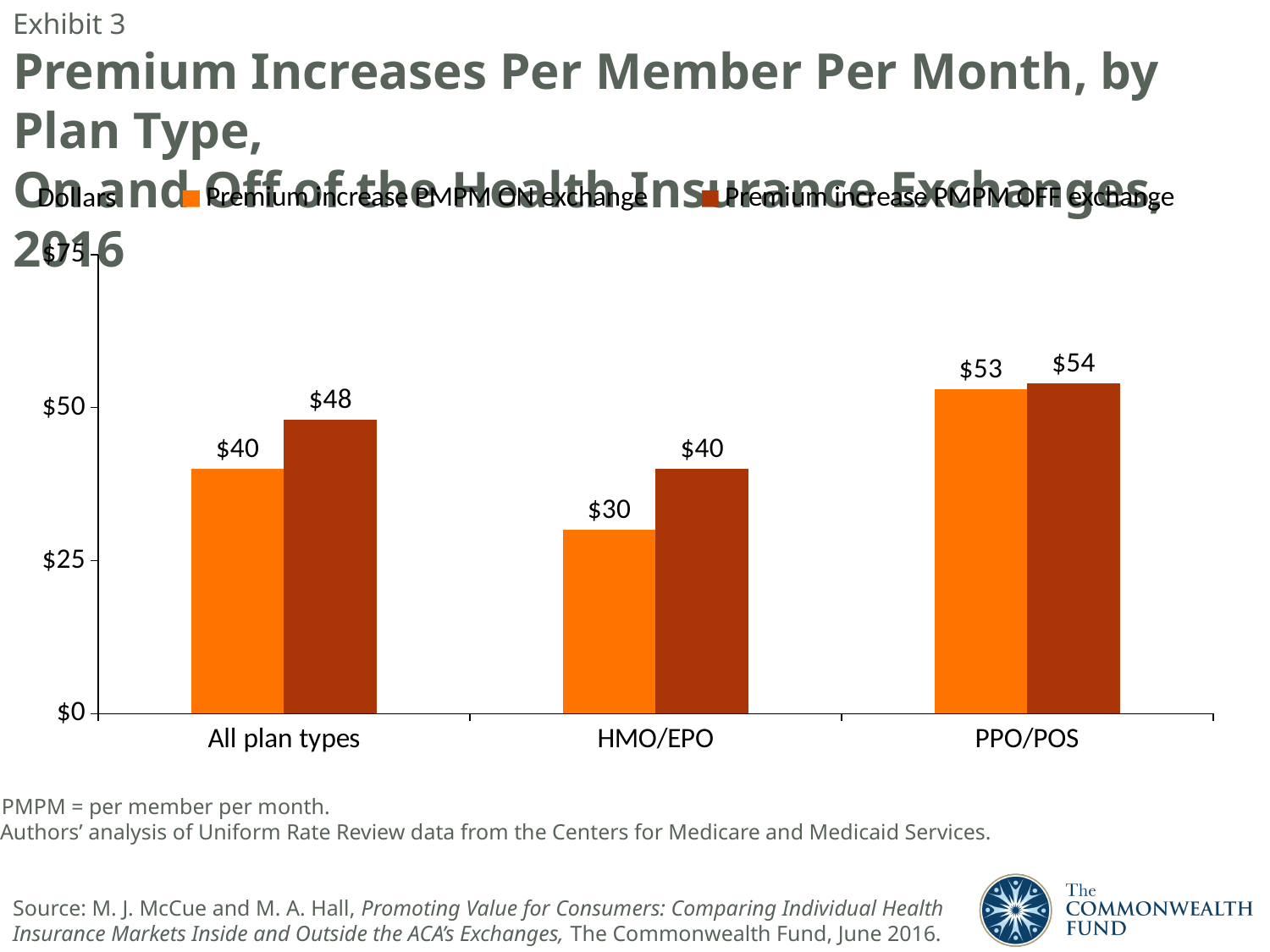
What is the difference between the OFF exchange and ON exchange premium increase for HMO/EPO? $10 Which plan type has the highest premium increase PMPM ON exchange? PPO/POS What kind of chart is shown on the slide? Bar chart Is the premium increase PMPM ON exchange for All plan types greater or less than $25? greater What is the difference between the ON exchange premium increase for PPO/POS and for HMO/EPO? $23 Which plan type has the lowest premium increase PMPM OFF exchange? HMO/EPO What is the premium increase PMPM OFF exchange for PPO/POS? $54 What is the premium increase PMPM ON exchange for HMO/EPO? $30 How many plan type categories are shown on the x axis? 3 How many series does the legend list? 2 What is the premium increase PMPM OFF exchange for All plan types? $48 Which is larger for All plan types: the ON exchange or the OFF exchange premium increase? OFF exchange